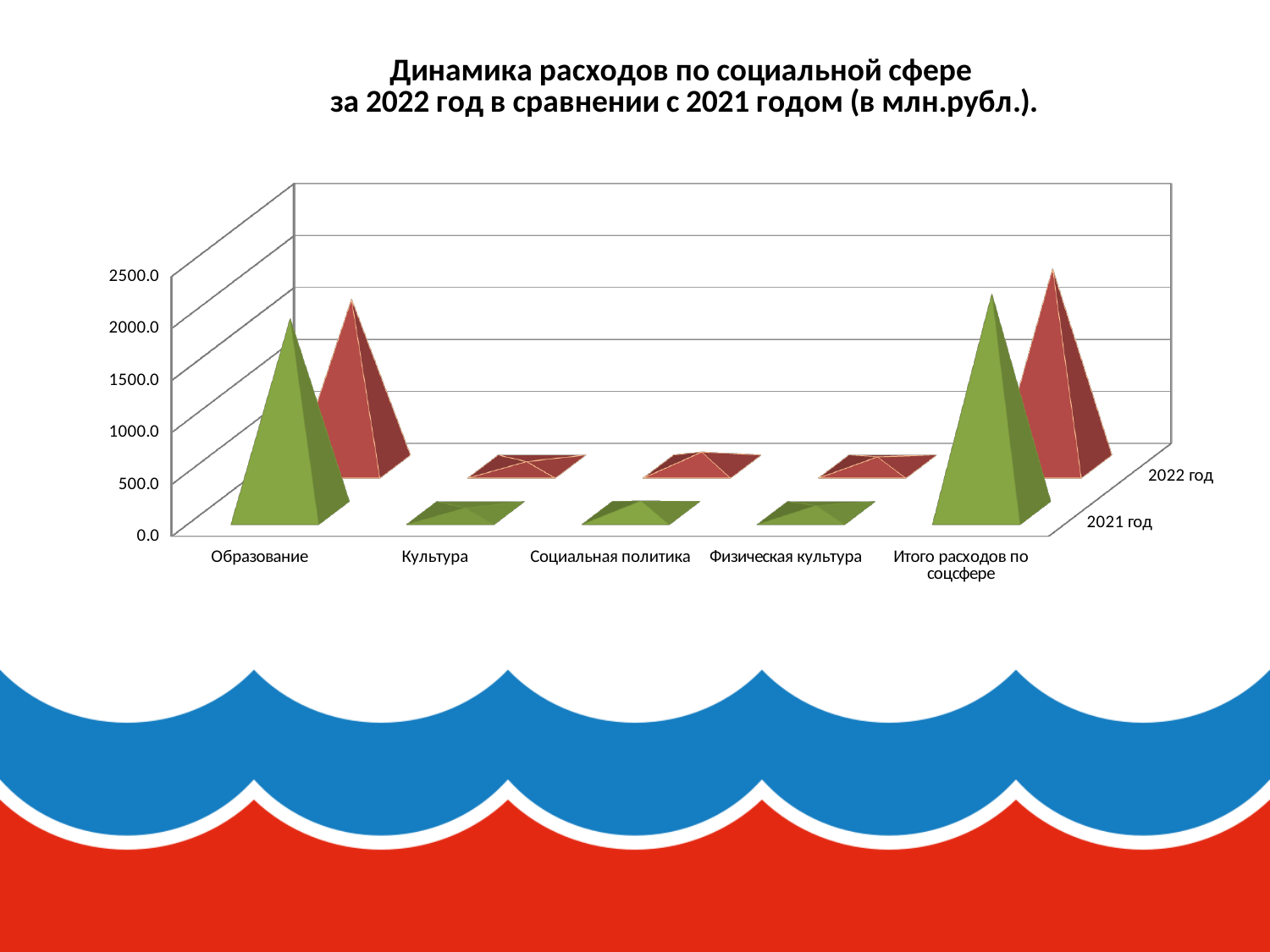
Is the value for Физическая культура in 2021 год greater or less than 1000? less Is the value for Культура in 2021 год greater or less than 500? less Is the value for Образование in 2021 год greater or less than 1500? greater For 2021 год, which is larger: Образование or Культура? Образование Which category has the highest value for 2021 год? Итого расходов по соцсфере What is the title of the chart? Динамика расходов по социальной сфере за 2022 год в сравнении с 2021 годом (в млн.рубл.). How many categories are shown along the x axis of the chart? 5 Which category has the highest value for 2022 год? Итого расходов по соцсфере For 2022 год, which is larger: Социальная политика or Итого расходов по соцсфере? Итого расходов по соцсфере What kind of chart is shown on the slide? bar chart How many series does the chart show? 2